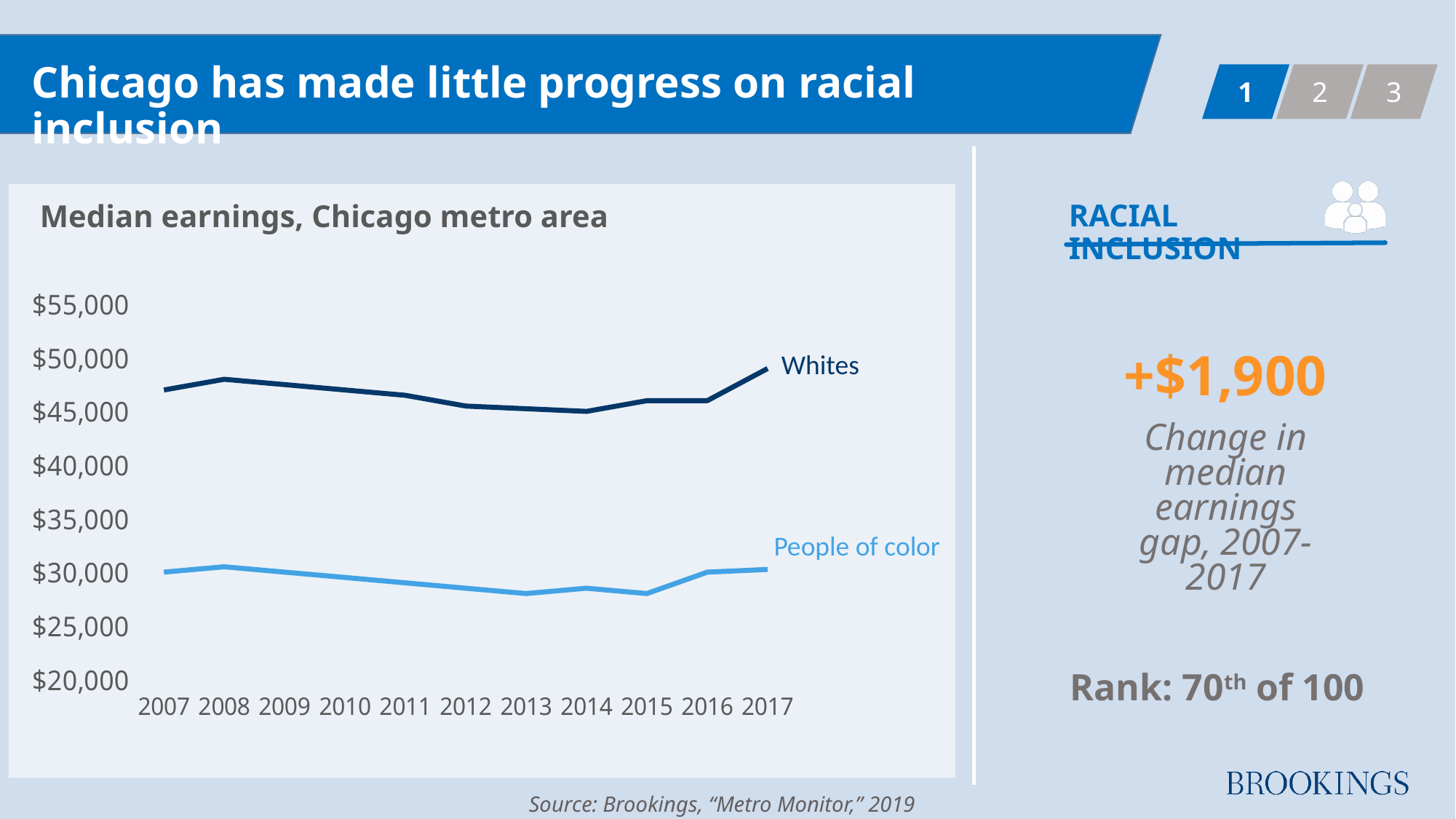
What kind of chart is shown on the slide? Line chart How many years are shown on the x axis of the chart? 11 Is the value for People of color in 2015 greater or less than $35,000? less What is the title of the chart? Median earnings, Chicago metro area Is the value for People of color in 2013 greater or less than $30,000? less Which series is drawn in the lighter blue line? People of color Which series has higher median earnings in 2017, Whites or People of color? Whites Is the value for Whites in 2017 greater or less than $45,000? greater Do median earnings for People of color rise or fall between 2008 and 2013? Fall Do median earnings for Whites rise or fall between 2014 and 2017? Rise How many series are plotted in the chart? 2